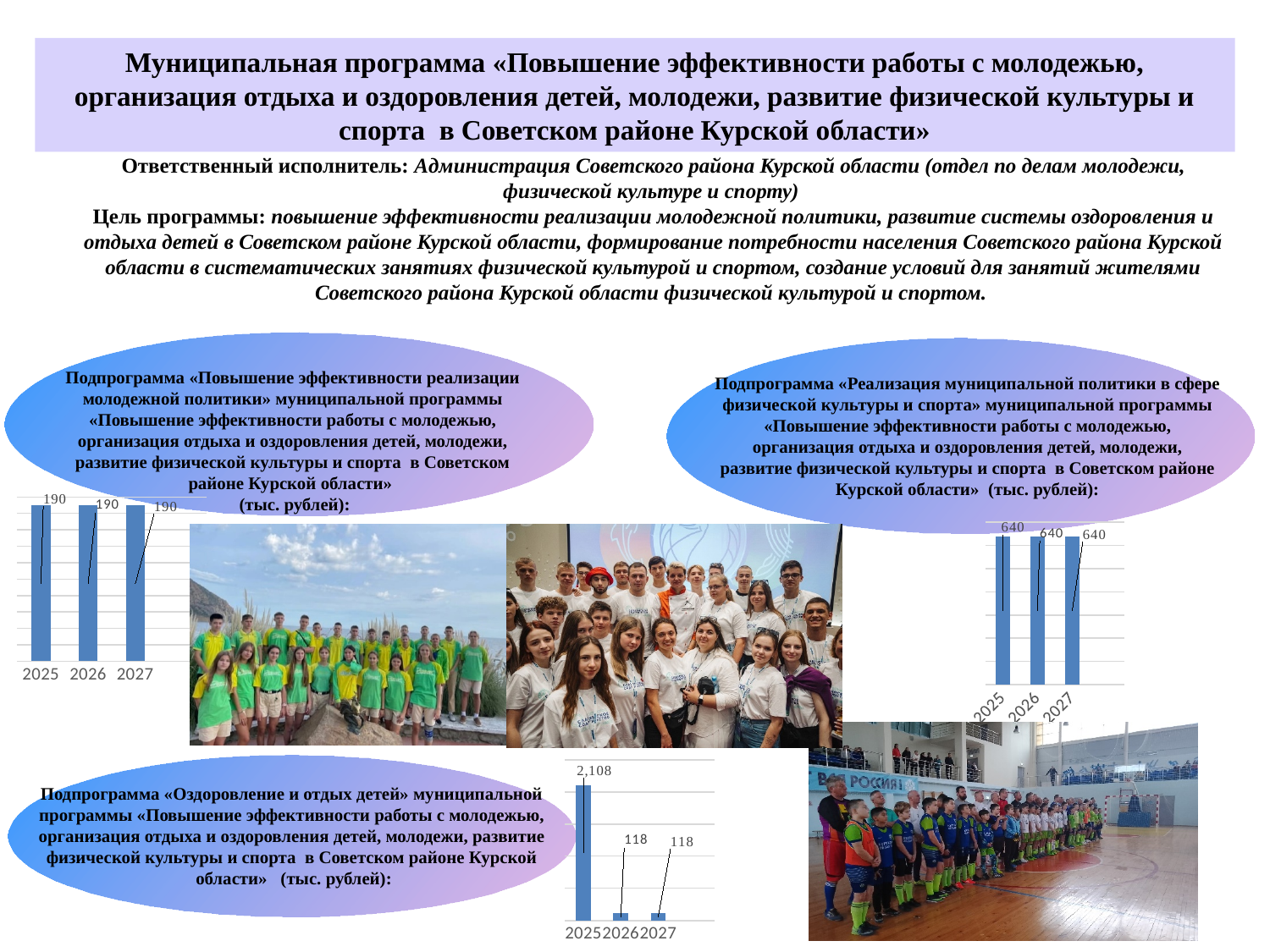
On the bottom chart (children's recreation subprogram), do the values rise or fall from 2025 to 2026? fall On the top-left chart (youth policy subprogram), how many years are shown on the x axis? 3 On the bottom chart (children's recreation subprogram), what is the value for 2025? 2,108 On the top-left chart (youth policy subprogram), what is the value for 2025? 190 On the bottom chart (children's recreation subprogram), which is larger, the value for 2025 or the value for 2026? 2025 On the bottom chart (children's recreation subprogram), what is the value for 2026? 118 On the top-right chart (physical culture and sport subprogram), what is the difference between the values for 2025 and 2026? 0 What kind of chart is the top-right chart (physical culture and sport subprogram)? bar chart On the bottom chart (children's recreation subprogram), which year has the highest value? 2025 On the top-right chart (physical culture and sport subprogram), what is the value for 2027? 640 On the bottom chart (children's recreation subprogram), what is the difference between the values for 2025 and 2027? 1,990 On the top-left chart (youth policy subprogram), do the values rise, fall or stay the same from 2025 to 2027? stay the same